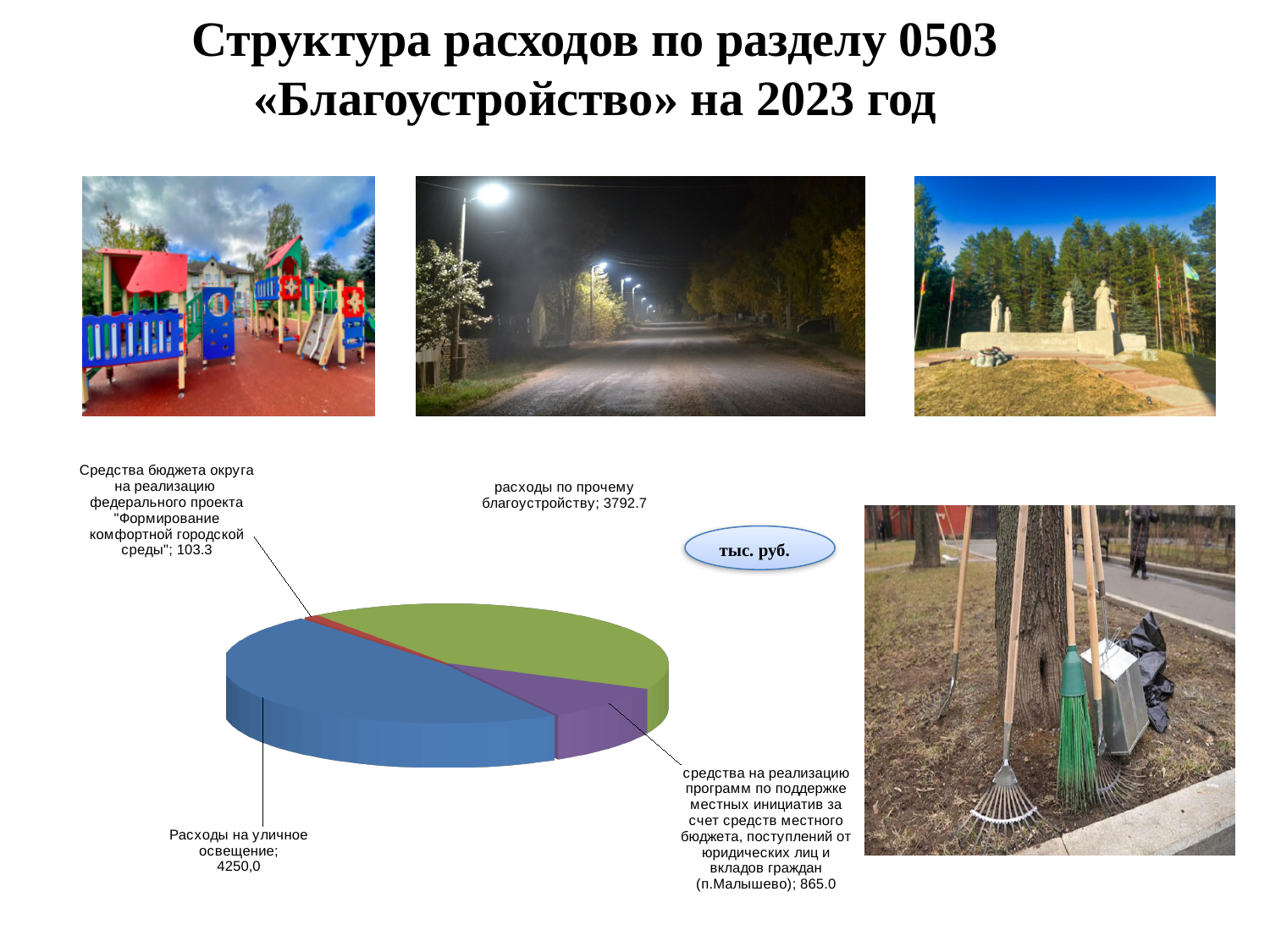
In what units are the values in the pie chart given, according to the callout on the slide? тыс. руб. What is the value for «расходы по прочему благоустройству» in the pie chart? 3792.7 Which category has the largest slice in the pie chart? Расходы на уличное освещение What is the difference between the value for «Расходы на уличное освещение» and the value for «расходы по прочему благоустройству»? 457.3 What kind of chart is shown on the slide? pie chart Which is larger: the value for «средства на реализацию программ по поддержке местных инициатив» or the value for the federal project «Формирование комфортной городской среды»? средства на реализацию программ по поддержке местных инициатив What is the value for «Расходы на уличное освещение» in the pie chart? 4250,0 What is the total of all four slices in the pie chart? 9011.0 What is the value for the slice «средства на реализацию программ по поддержке местных инициатив ... (п.Малышево)»? 865.0 Which category has the smallest slice in the pie chart? Средства бюджета округа на реализацию федерального проекта "Формирование комфортной городской среды" How many slices does the pie chart have? 4 What is the value for «Средства бюджета округа на реализацию федерального проекта "Формирование комфортной городской среды"»? 103.3